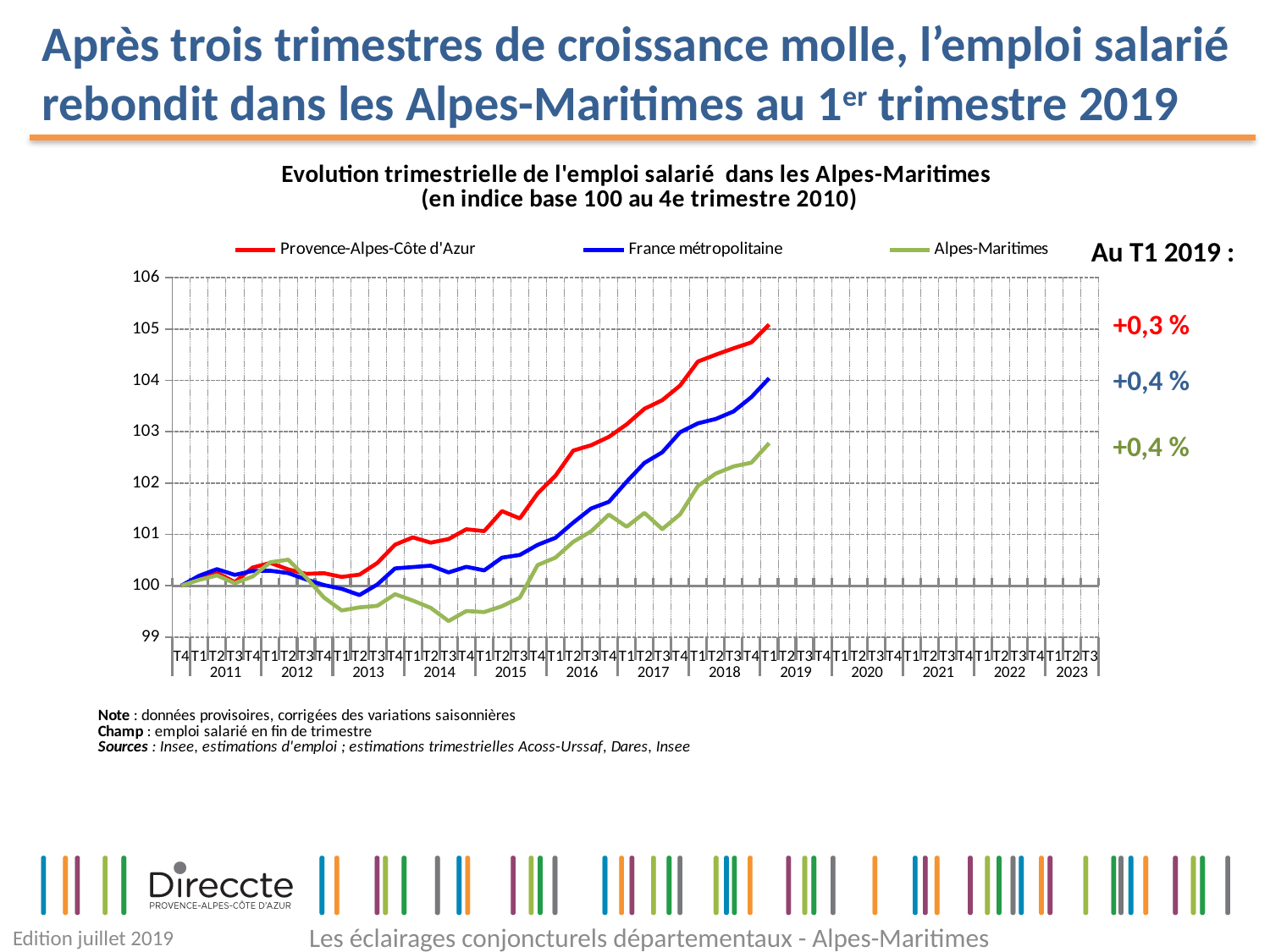
How many series does the legend list? 3 What kind of chart is shown on the slide? line chart Which series has the highest value at T1 2019? Provence-Alpes-Côte d'Azur Is the value for Alpes-Maritimes at T1 2019 greater or less than 103? less Which series is drawn in red? Provence-Alpes-Côte d'Azur Is the value for Provence-Alpes-Côte d'Azur at T1 2019 greater or less than 104? greater Is the value for Alpes-Maritimes at T3 2014 greater or less than 100? less At T1 2019, which is larger: the value for France métropolitaine or the value for Alpes-Maritimes? France métropolitaine Do the values for Provence-Alpes-Côte d'Azur generally rise or fall from 2013 to 2019? rise Which series has the lowest value at T1 2019? Alpes-Maritimes What quarterly change is shown for Provence-Alpes-Côte d'Azur at T1 2019 in the annotation on the right? +0,3 %